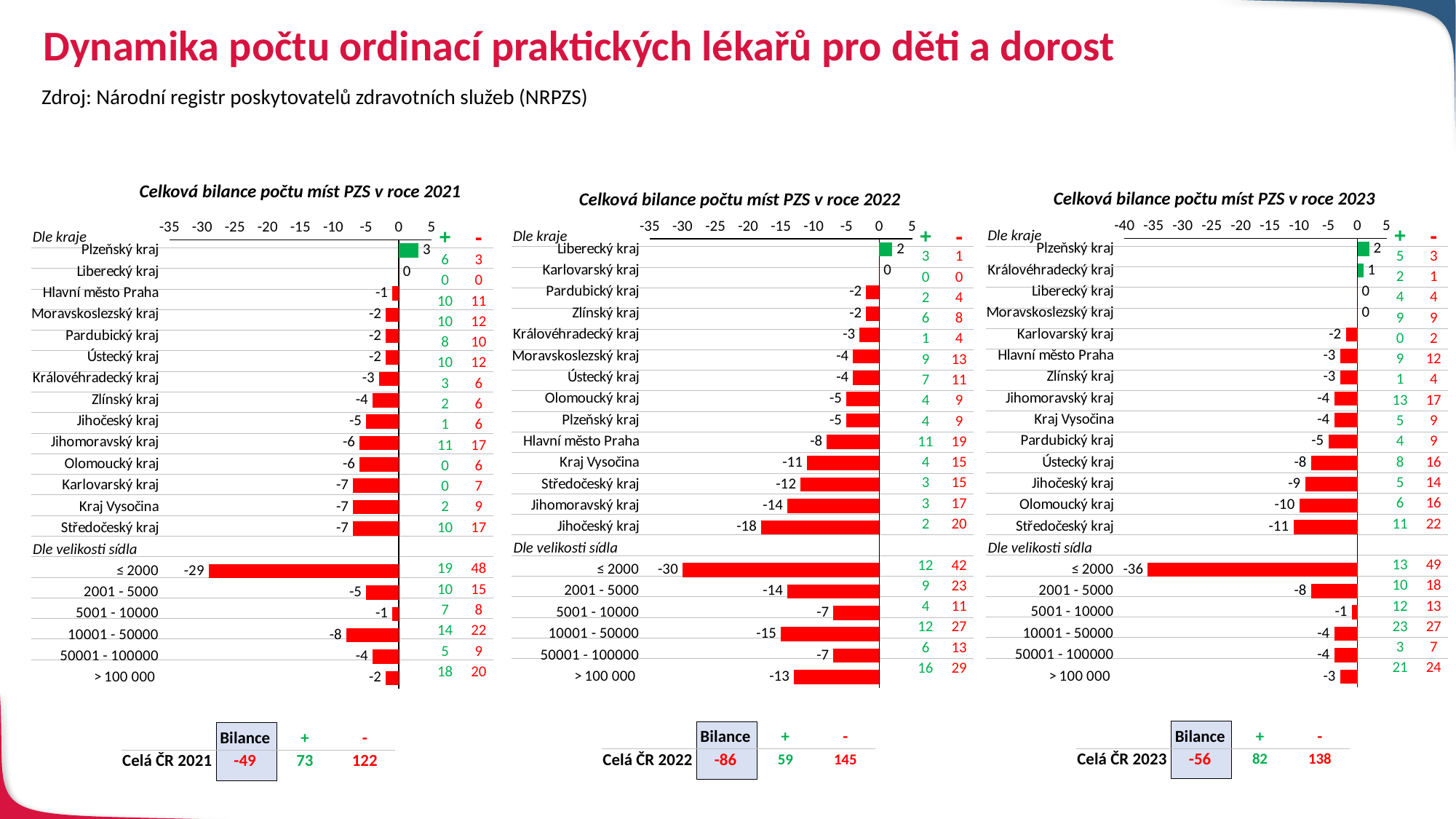
In the chart 'Celková bilance počtu míst PZS v roce 2022', which region (kraj) has the highest value? Liberecký kraj In the chart 'Celková bilance počtu míst PZS v roce 2021', what is the value for Plzeňský kraj? 3 In the chart 'Celková bilance počtu míst PZS v roce 2021', is the value for the category '≤ 2000' greater or less than -25? less How many bars (categories) are plotted in the chart 'Celková bilance počtu míst PZS v roce 2022'? 20 In the chart 'Celková bilance počtu míst PZS v roce 2021', which category has the lowest value? ≤ 2000 In the chart 'Celková bilance počtu míst PZS v roce 2021', what colour is the bar for Plzeňský kraj? green In the chart 'Celková bilance počtu míst PZS v roce 2023', what is the value for the category '≤ 2000'? -36 In the chart 'Celková bilance počtu míst PZS v roce 2023', which region (kraj) has the lowest value? Středočeský kraj In the chart 'Celková bilance počtu míst PZS v roce 2023', which is larger, the value for Ústecký kraj or the value for Olomoucký kraj? Ústecký kraj In the chart 'Celková bilance počtu míst PZS v roce 2022', what is the value for Jihočeský kraj? -18 In the chart 'Celková bilance počtu míst PZS v roce 2022', what is the difference between the values for Kraj Vysočina and Hlavní město Praha? 3 What type of chart is 'Celková bilance počtu míst PZS v roce 2023'? bar chart